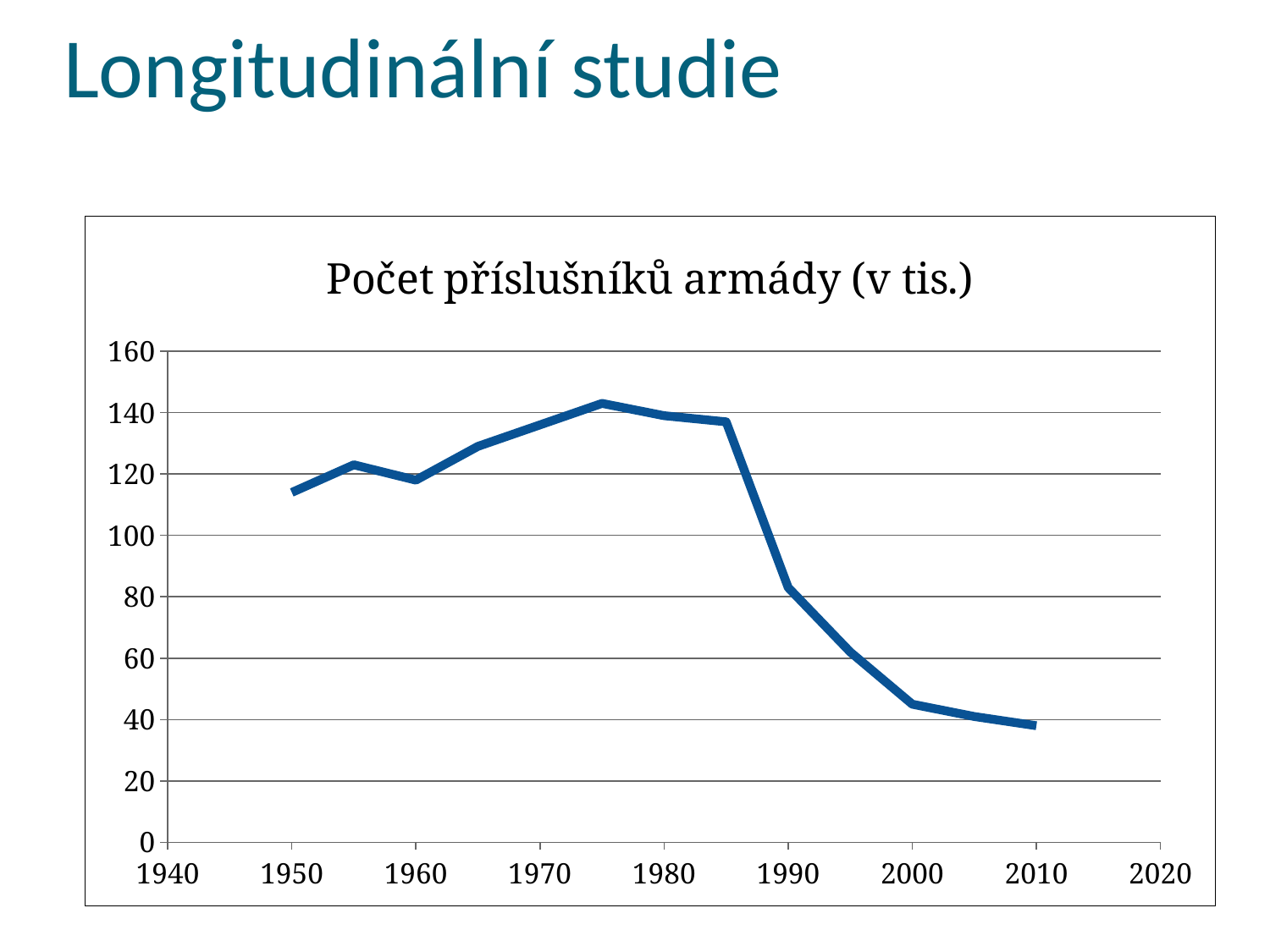
What kind of chart is shown on the slide? line chart Which year has the larger value, 1975 or 2000? 1975 In which year does the line reach its lowest value? 2010 What is the title of the chart? Počet příslušníků armády (v tis.) Is the value for 2010 greater or less than 60? less Do the values rise or fall between 1985 and 2010? fall Is the value for 1990 greater or less than 100? less Is the value for 1950 greater or less than 100? greater In which year does the line reach its highest value? 1975